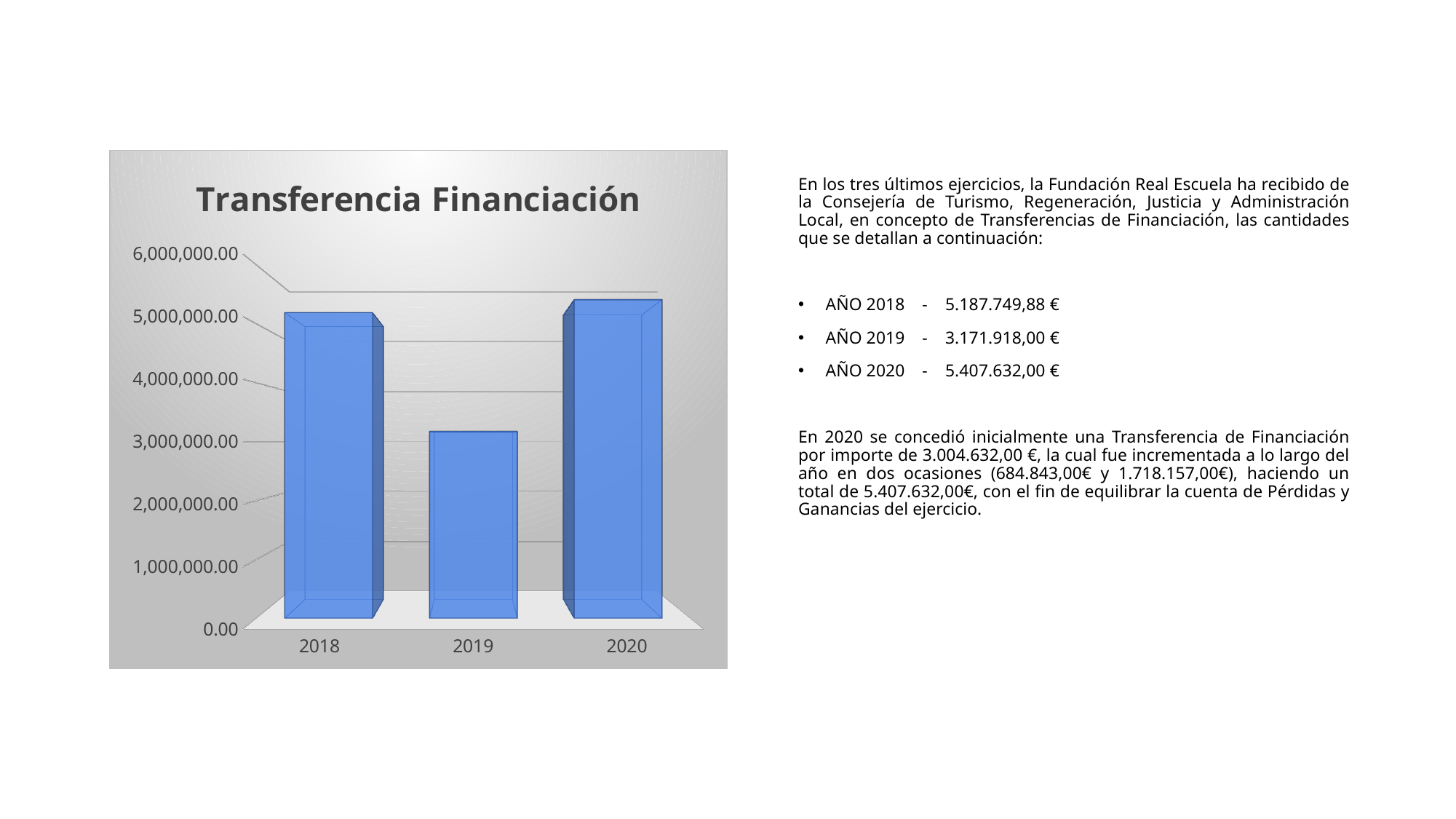
How many years are shown on the x axis of the chart? 3 Which bar is taller, 2018 or 2020? 2020 Which year has the highest bar in the chart? 2020 What kind of chart is shown on the slide? bar chart According to the slide, what was the Transferencia de Financiación amount for 2020? 5.407.632,00 € Is the value for 2020 greater or less than 5,000,000.00? greater Which year has the lowest bar in the chart? 2019 According to the slide, what was the Transferencia de Financiación amount for 2019? 3.171.918,00 € Do the values rise or fall from 2018 to 2019 in the chart? fall Is the value for 2019 greater or less than 4,000,000.00? less What is the title of the chart? Transferencia Financiación Is the value for 2018 greater or less than 4,000,000.00? greater